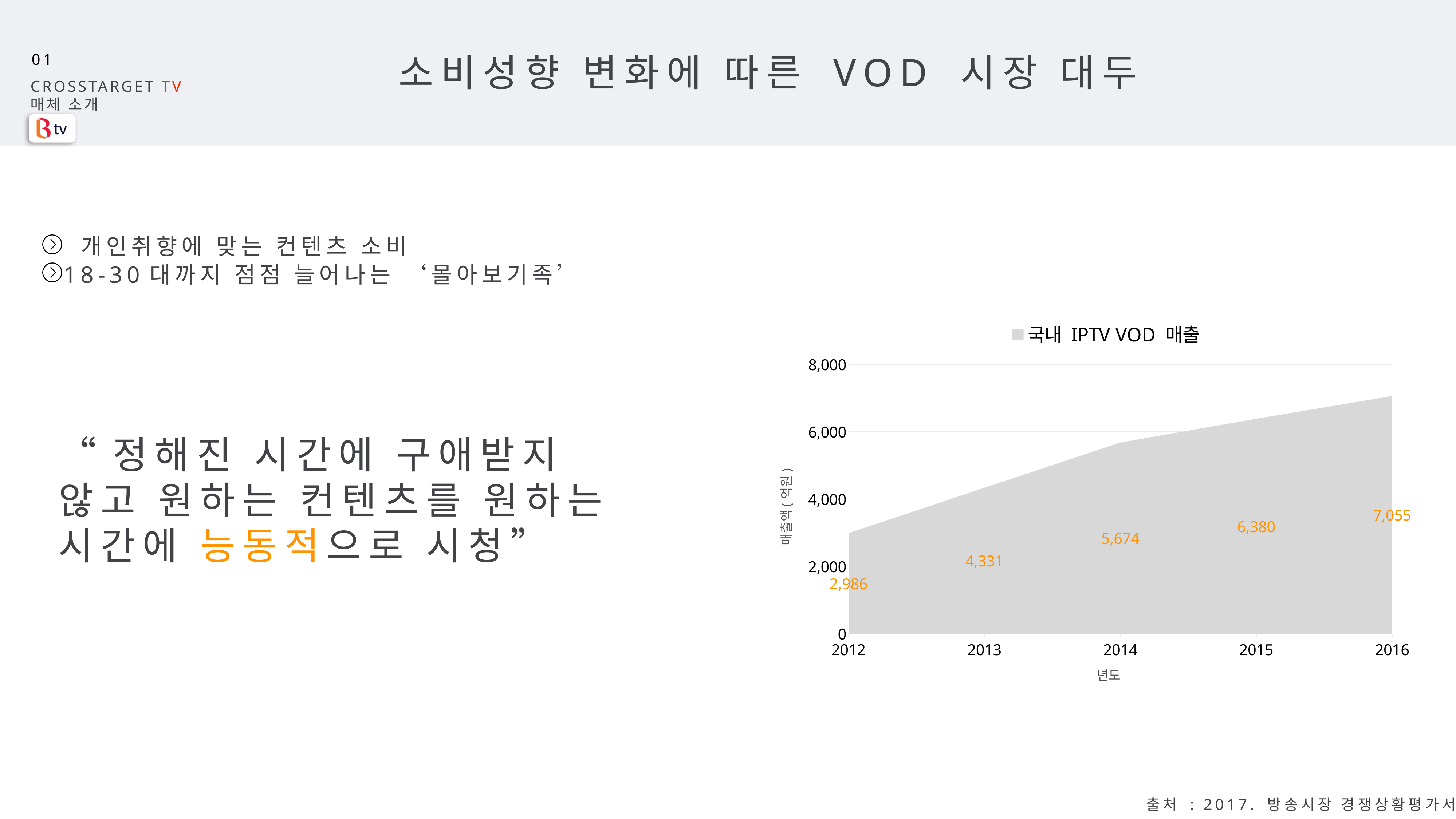
What is the value for 2012 in the chart? 2,986 How many series does the legend list? 1 What kind of chart is shown on the slide? area chart What is the value for 2016 in the chart? 7,055 What is the difference between the values for 2015 and 2013? 2,049 Which year has the lowest value in the chart? 2012 What is the value for 2014 in the chart? 5,674 Which year has the highest value in the chart? 2016 How many years are plotted on the x axis? 5 Which is larger, the value for 2013 or the value for 2014? 2014 Do the values rise or fall from 2012 to 2016? rise Is the value for 2015 greater or less than 6,000? greater